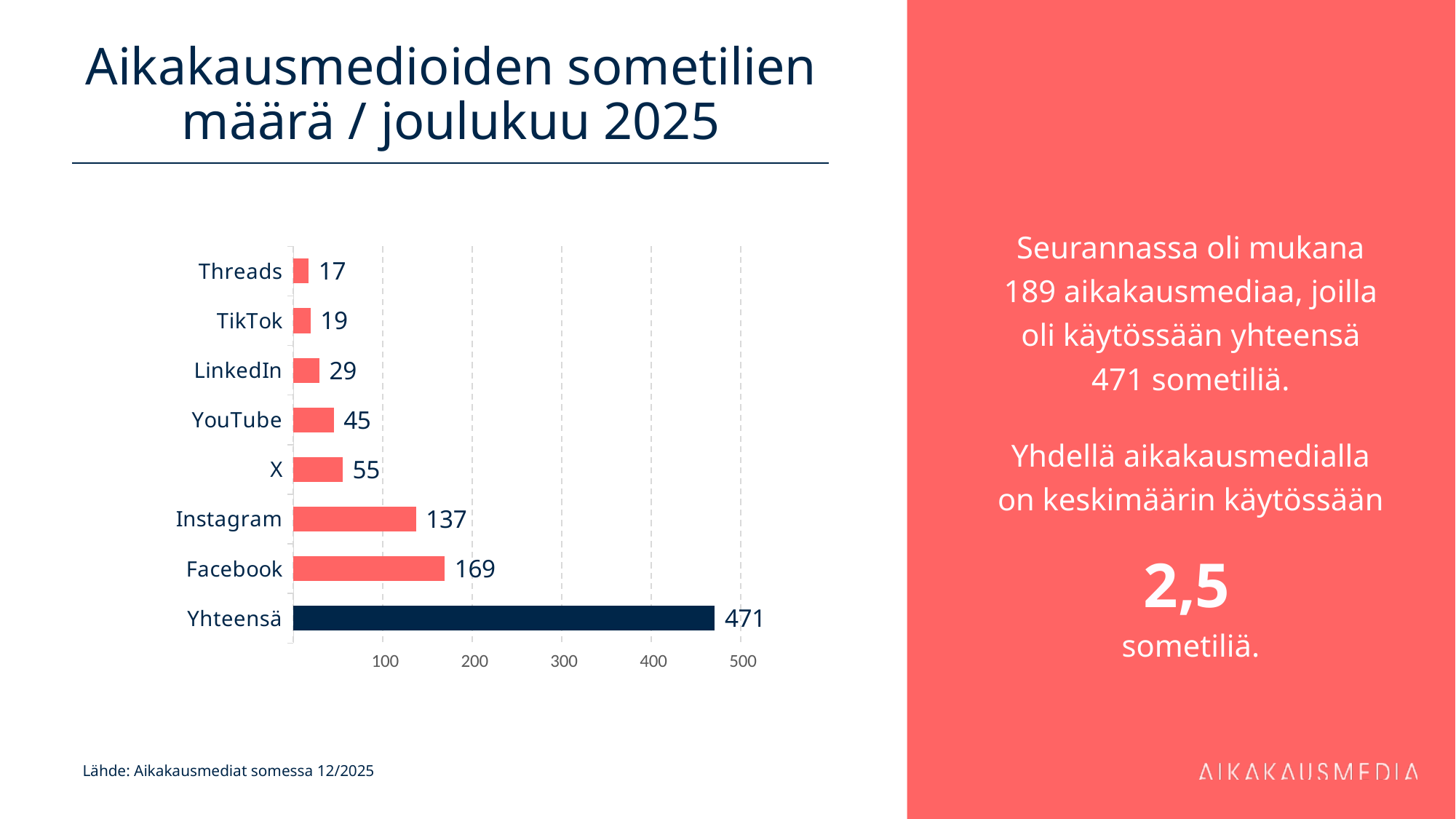
What is the difference between the values for X and YouTube? 10 How many bars are shown in the chart, including the Yhteensä bar? 8 What is the value for Instagram? 137 What is the title of the slide? Aikakausmedioiden sometilien määrä / joulukuu 2025 Excluding the Yhteensä total bar, which platform has the highest value? Facebook Which platform has the lowest value? Threads Which is larger, the value for TikTok or the value for LinkedIn? LinkedIn What is the value for Facebook? 169 What kind of chart is shown on the slide? Bar chart What is the difference between the values for Facebook and Instagram? 32 What is the value shown for Yhteensä? 471 What is the value for LinkedIn? 29